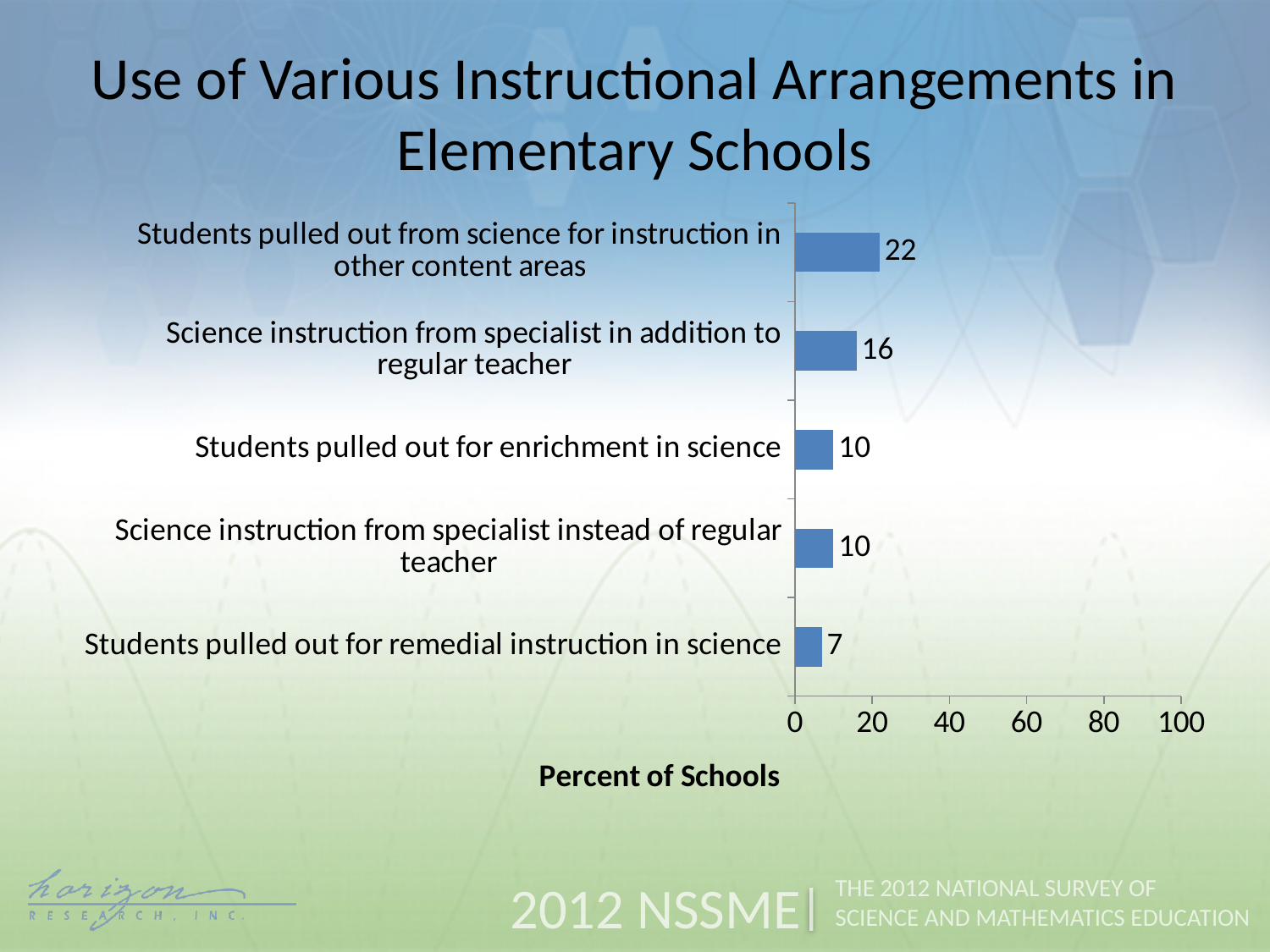
What is the difference in percent of schools between students pulled out from science for instruction in other content areas and students pulled out for remedial instruction in science? 15 How many instructional arrangements are shown in the chart? 5 What kind of chart is shown on the slide? Bar chart What percent of schools have students pulled out for enrichment in science? 10 Which instructional arrangement has the highest percent of schools? Students pulled out from science for instruction in other content areas What percent of schools have students pulled out for remedial instruction in science? 7 Which instructional arrangement has the lowest percent of schools? Students pulled out for remedial instruction in science Which is larger: the percent of schools with science instruction from a specialist in addition to the regular teacher, or the percent with science instruction from a specialist instead of the regular teacher? Science instruction from specialist in addition to regular teacher Is the value for students pulled out from science for instruction in other content areas greater or less than 40? less What percent of schools have science instruction from a specialist in addition to the regular teacher? 16 What percent of schools have students pulled out from science for instruction in other content areas? 22 What is the label of the horizontal axis? Percent of Schools